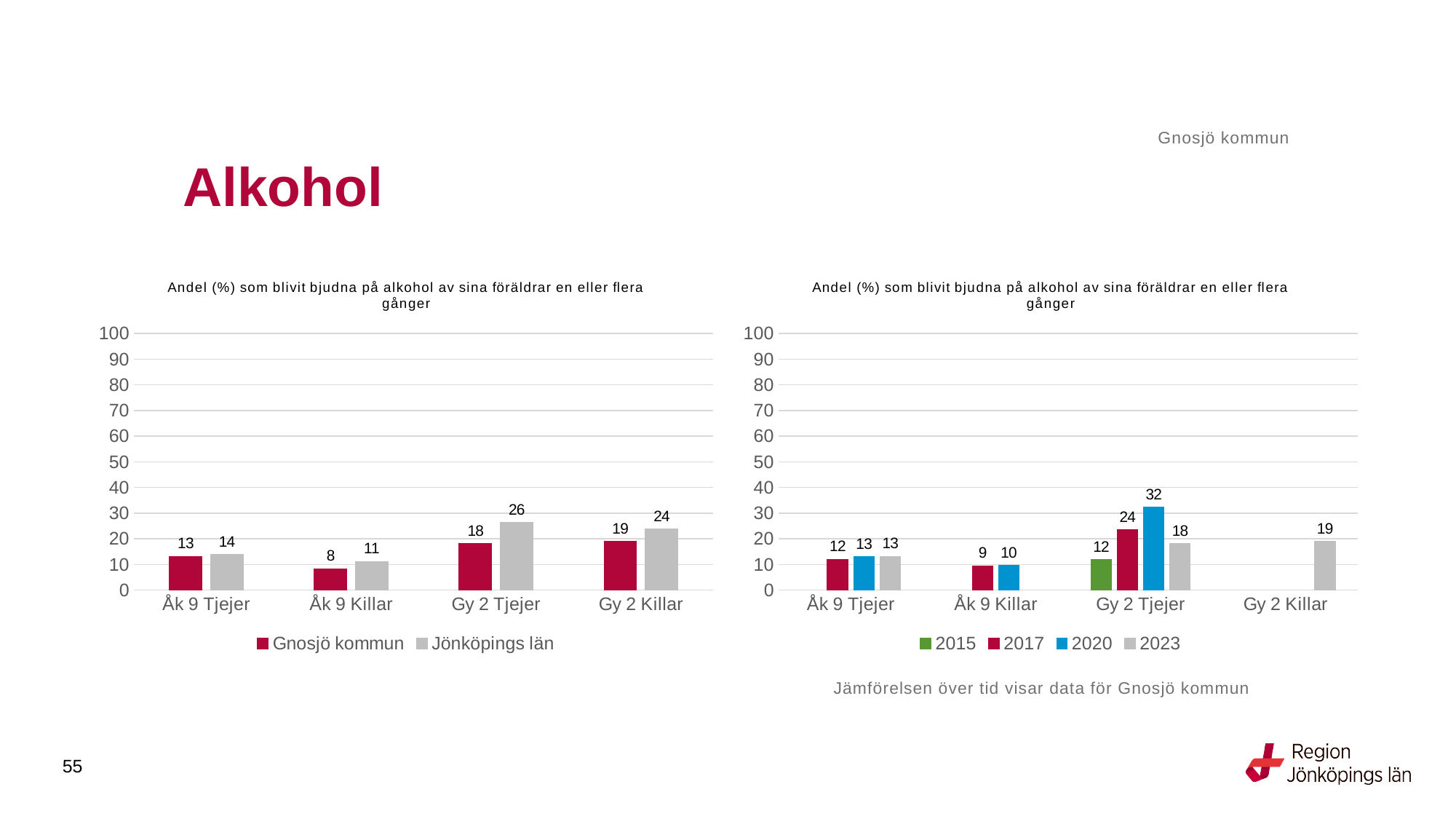
In the left chart, what is the difference between Jönköpings län and Gnosjö kommun for Gy 2 Tjejer? 8 In the right chart, which year has the highest value for Gy 2 Tjejer? 2020 In the left chart, how many series does the legend list? 2 In the left chart, which category has the highest value for Jönköpings län? Gy 2 Tjejer In the left chart, what is the value for Jönköpings län for Åk 9 Killar? 11 In the left chart, what is the value for Gnosjö kommun for Gy 2 Tjejer? 18 What kind of chart is the right chart? bar chart In the right chart, is the value for 2017 for Åk 9 Killar larger or smaller than the value for 2020 for Åk 9 Killar? smaller In the right chart, how many series does the legend list? 4 In the right chart, what is the value for 2023 for Gy 2 Killar? 19 In the right chart, what is the value for 2020 for Gy 2 Tjejer? 32 In the left chart, which category has the lowest value for Gnosjö kommun? Åk 9 Killar